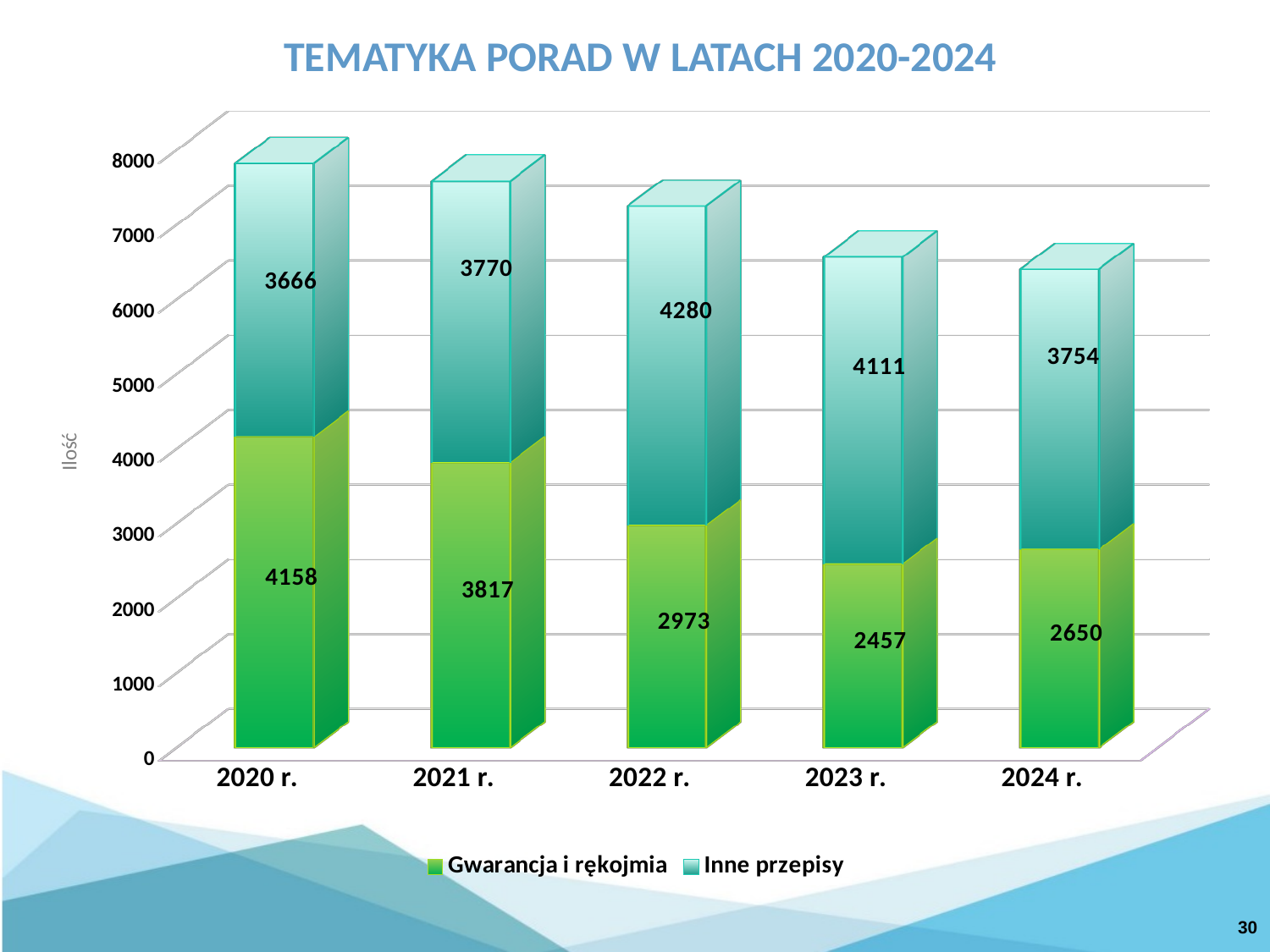
What is the value for Inne przepisy in 2024 r.? 3754 In which year is the value for Inne przepisy the highest? 2022 r. What is the total of the stacked bar for 2024 r.? 6404 What kind of chart is shown on the slide? Stacked bar chart In which year is the value for Gwarancja i rękojmia the lowest? 2023 r. What is the value for Inne przepisy in 2022 r.? 4280 What is the value for Gwarancja i rękojmia in 2020 r.? 4158 How many series does the legend list? 2 How many years are shown on the x axis? 5 What is the difference between the Gwarancja i rękojmia values for 2020 r. and 2021 r.? 341 What is the total of the stacked bar for 2020 r.? 7824 Which is larger in 2023 r.: Gwarancja i rękojmia or Inne przepisy? Inne przepisy